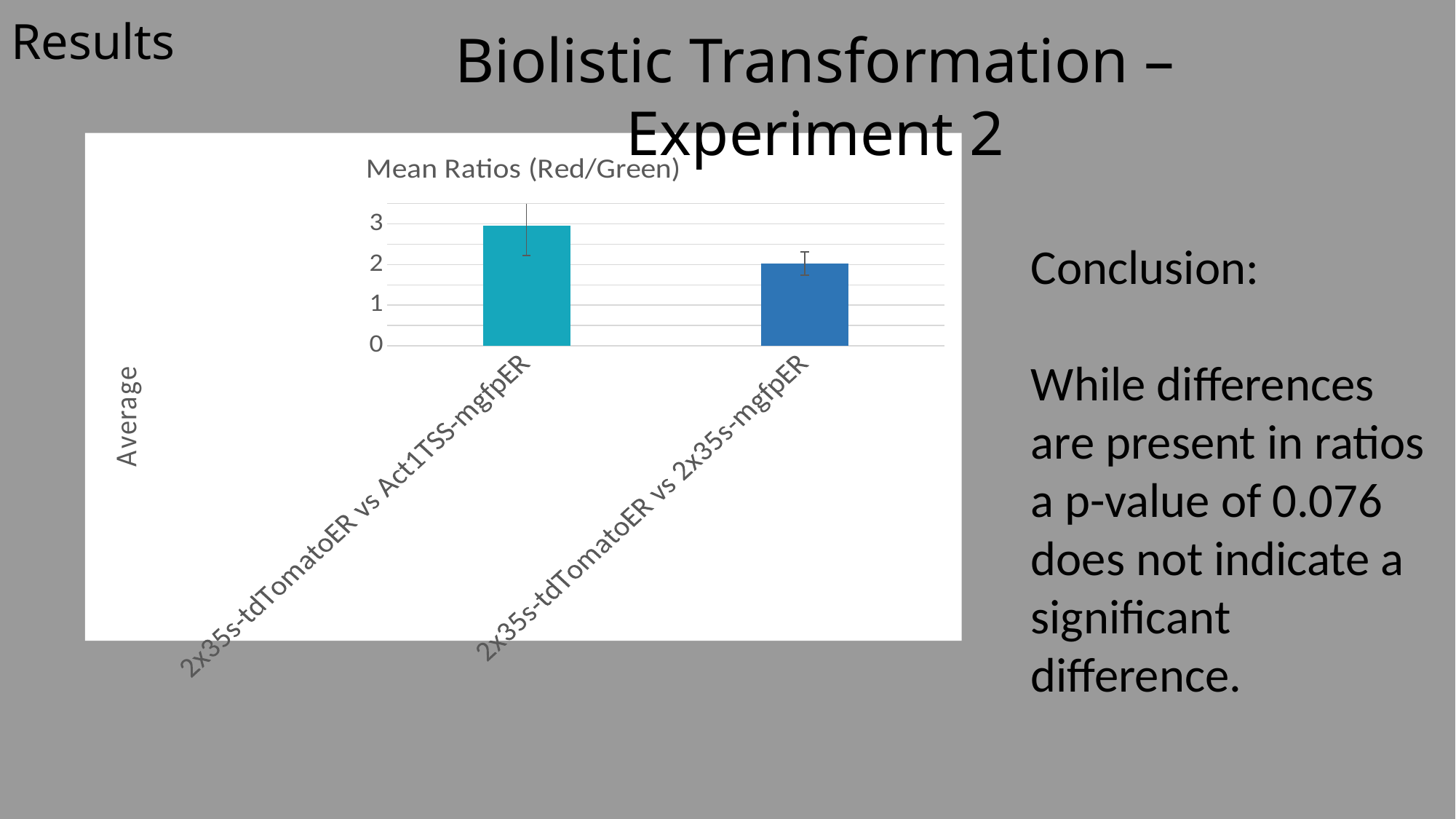
Is the value for 2x35s-tdTomatoER vs 2x35s-mgfpER greater or less than 1? greater Which category has the lowest mean ratio? 2x35s-tdTomatoER vs 2x35s-mgfpER Which is larger: the mean ratio for 2x35s-tdTomatoER vs Act1TSS-mgfpER or for 2x35s-tdTomatoER vs 2x35s-mgfpER? 2x35s-tdTomatoER vs Act1TSS-mgfpER What is the title of the chart? Mean Ratios (Red/Green) What kind of chart is shown on the slide? bar chart How many bars (categories) are plotted in the chart? 2 Which category has the highest mean ratio? 2x35s-tdTomatoER vs Act1TSS-mgfpER What is the label on the vertical axis of the chart? Average Is the value for 2x35s-tdTomatoER vs 2x35s-mgfpER greater or less than 3? less Is the value for 2x35s-tdTomatoER vs Act1TSS-mgfpER greater or less than 2? greater